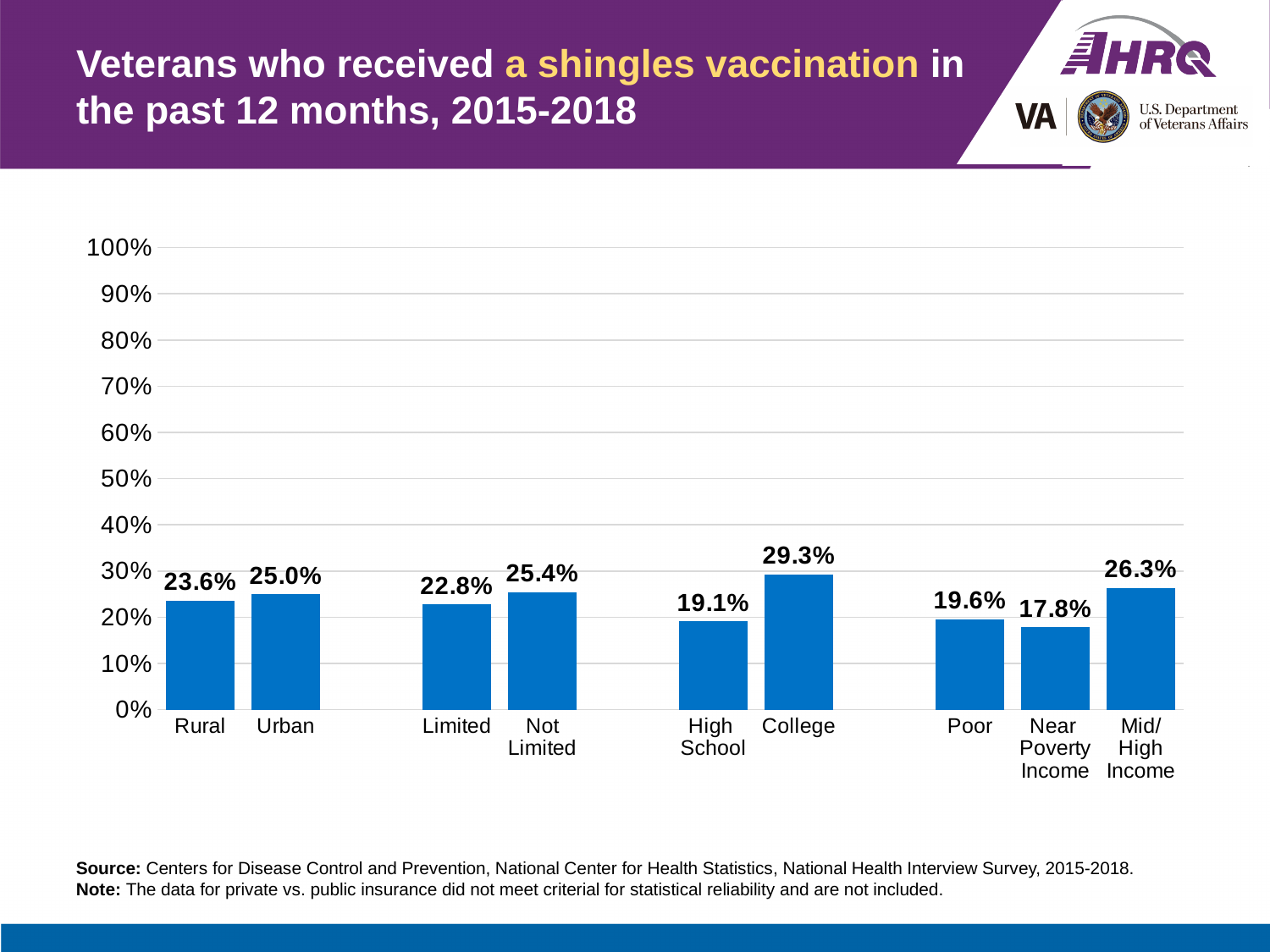
What is the value shown for Near Poverty Income? 17.8% What is the highest value shown on the vertical axis? 100% What is the difference between the values for College and High School? 10.2% Is the value for Mid/High Income greater or less than 20%? greater Which category has the highest value on the chart? College What percentage of Rural veterans received a shingles vaccination in the past 12 months? 23.6% Which category has the lowest value on the chart? Near Poverty Income What is the difference between the values for Urban and Rural? 1.4% What kind of chart is shown on the slide? Bar chart What is the value shown for College? 29.3% How many bars are shown on the chart? 9 Which is larger, the value for Limited or the value for Not Limited? Not Limited